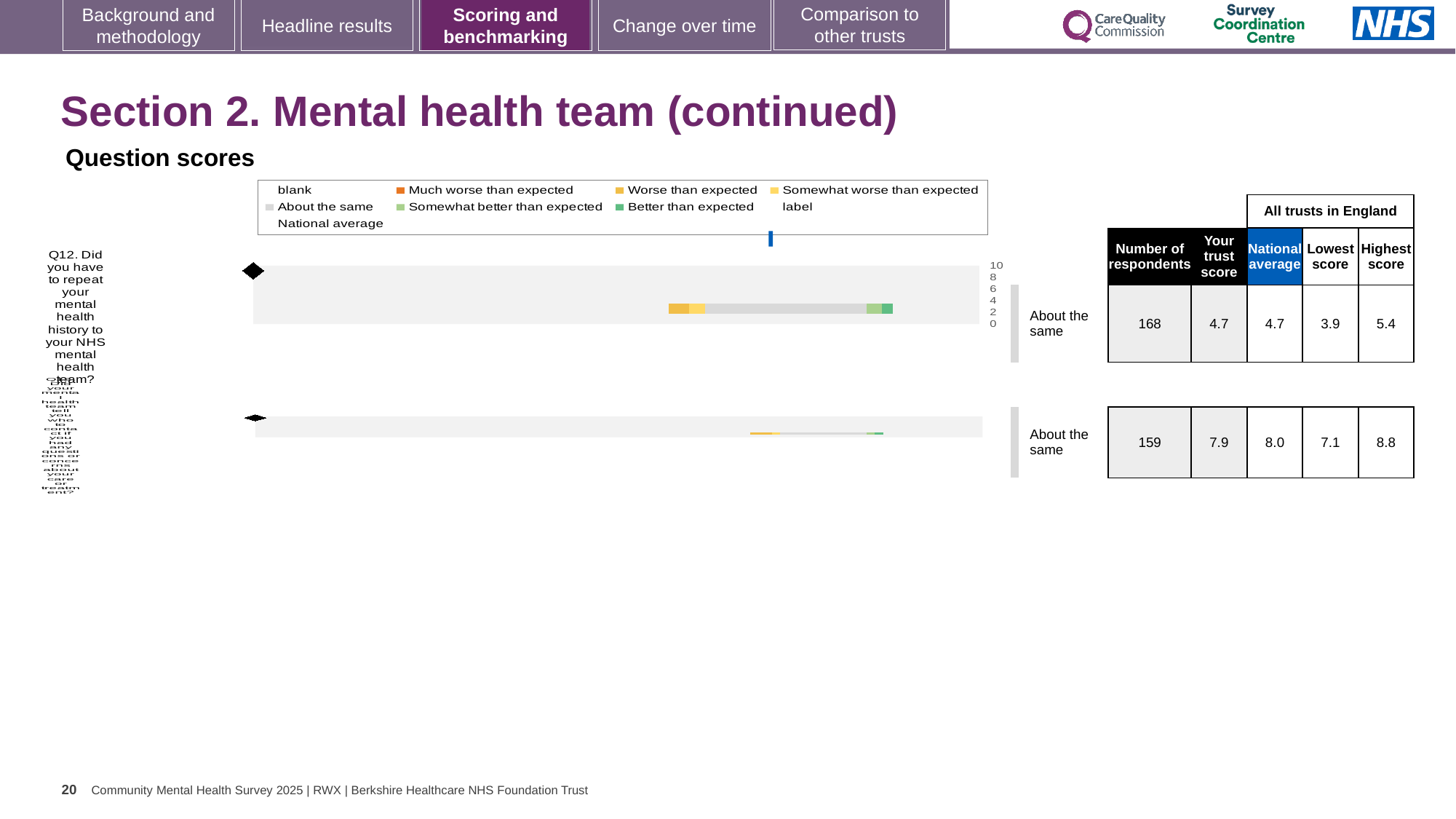
What is the benchmark category shown for Q12 (repeating mental health history)? About the same What kind of chart is used to show the question scores on this slide? bar chart What is the national average for Q12? 4.7 What is the highest score across all trusts in England for Q12? 5.4 For the second question row on the slide, what is the trust score? 7.9 For the second question row, is the trust score higher or lower than the national average? lower How many respondents are listed for Q12 in the table next to the chart? 168 How many question rows are plotted in the question scores chart? 2 For the second question row, what is the difference between the highest score (8.8) and the lowest score (7.1)? 1.7 What is the difference between the highest and lowest trust scores for Q12? 1.5 What is the trust score for Q12? 4.7 Which colour in the legend represents 'Much worse than expected'? orange